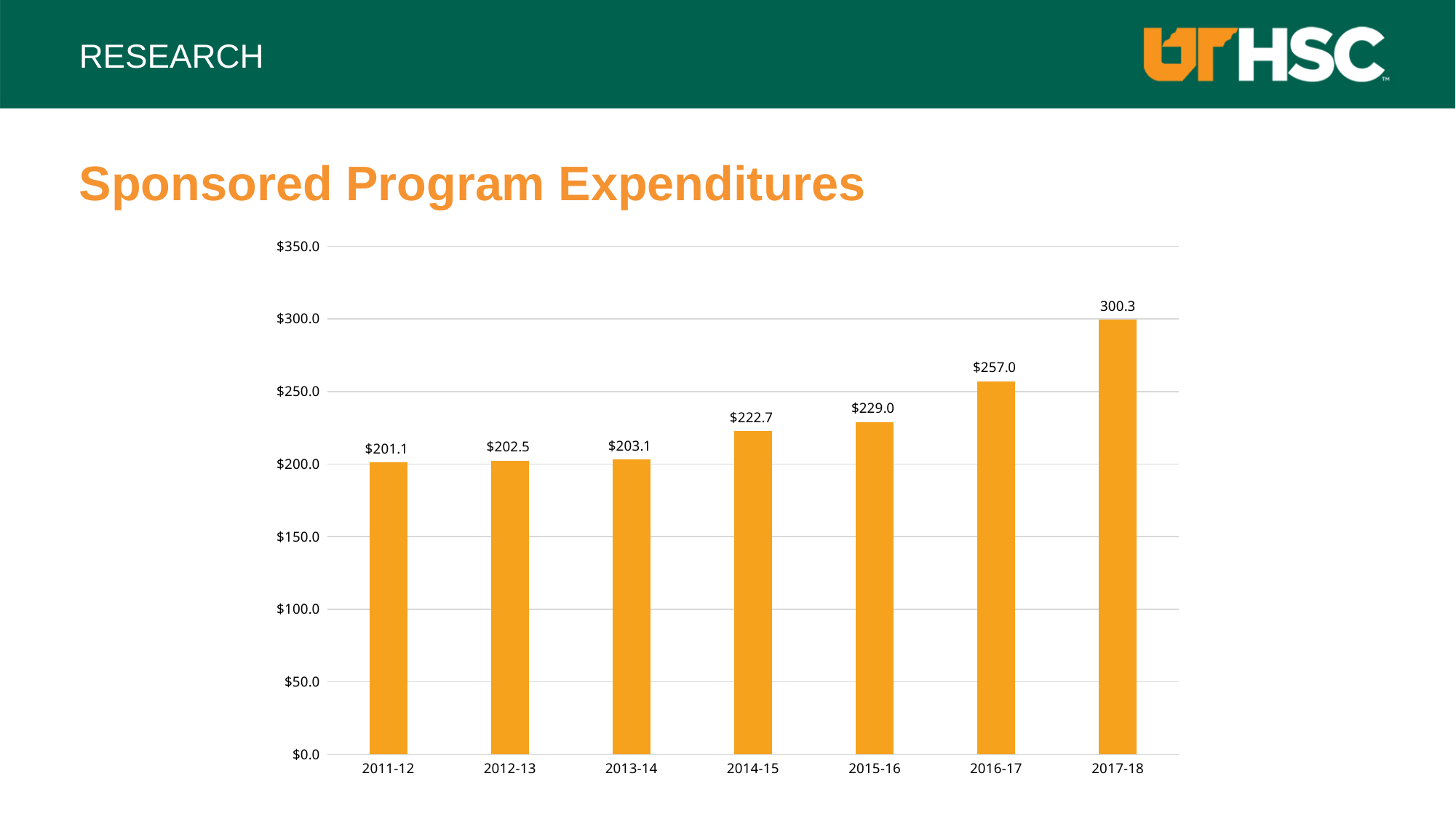
What kind of chart is shown? bar chart How many years are shown on the chart? 7 What is the value for 2011-12? $201.1 What is the difference between the values for 2015-16 and 2014-15? 6.3 Do the values rise or fall from 2011-12 to 2017-18? rise What is the value for 2017-18? 300.3 What is the value for 2016-17? $257.0 Which year has the lowest value? 2011-12 Which is larger, the value for 2013-14 or the value for 2015-16? 2015-16 What is the difference between the values for 2017-18 and 2016-17? 43.3 What is the value for 2014-15? $222.7 Which year has the highest value? 2017-18